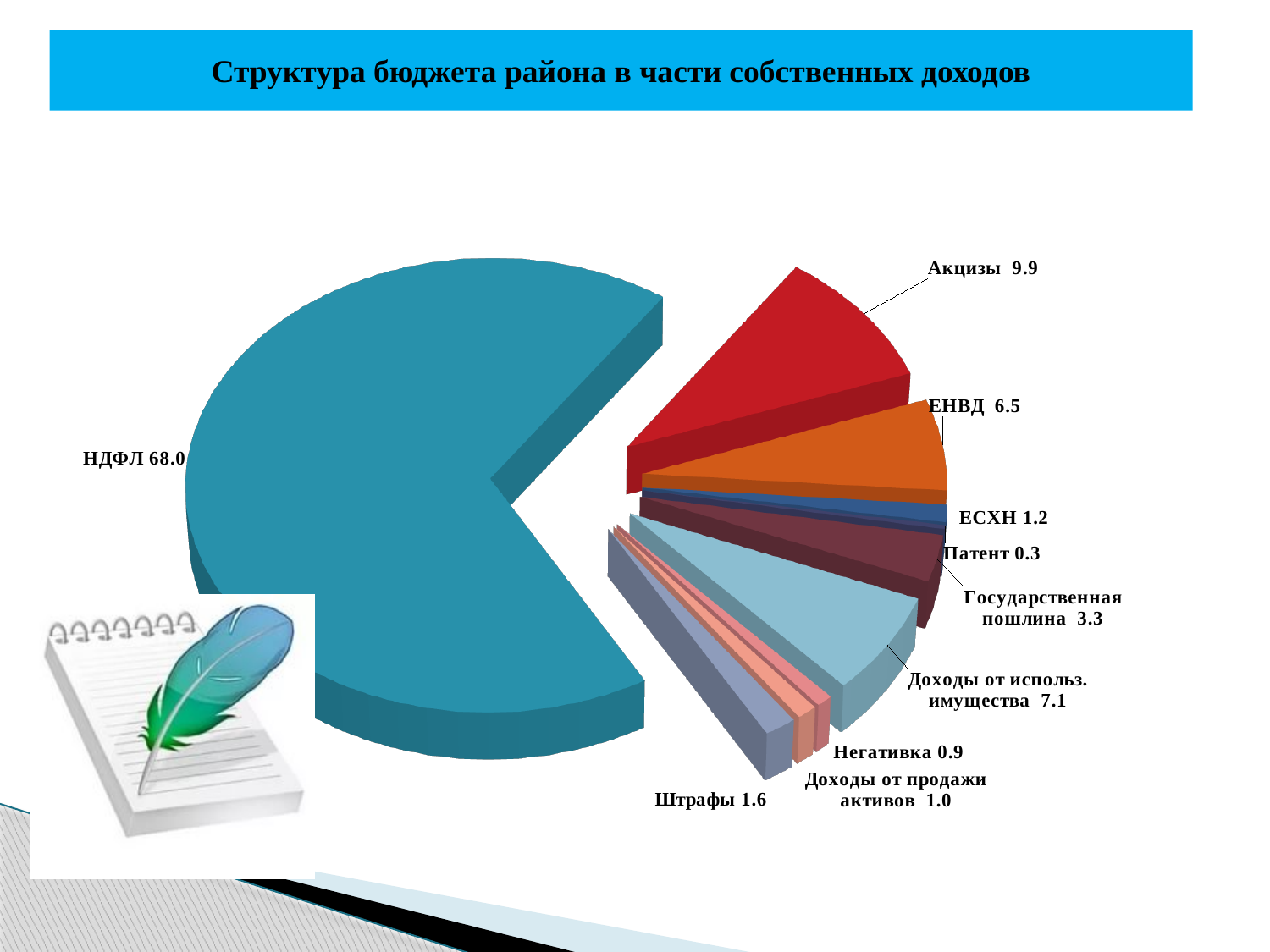
Which category has the smallest slice of the pie? Патент What is the value shown for Государственная пошлина? 3.3 What is the value shown for Доходы от использ. имущества? 7.1 What is the title of the chart on the slide? Структура бюджета района в части собственных доходов What is the value shown for НДФЛ? 68.0 What is the value shown for Акцизы? 9.9 Which category has the largest slice of the pie? НДФЛ What kind of chart is shown on the slide? pie chart How many categories (slices) does the pie chart have? 10 What is the value shown for Негативка? 0.9 Which is larger, the value for Штрафы or the value for ЕСХН? Штрафы What is the difference between the values for Акцизы and ЕНВД? 3.4